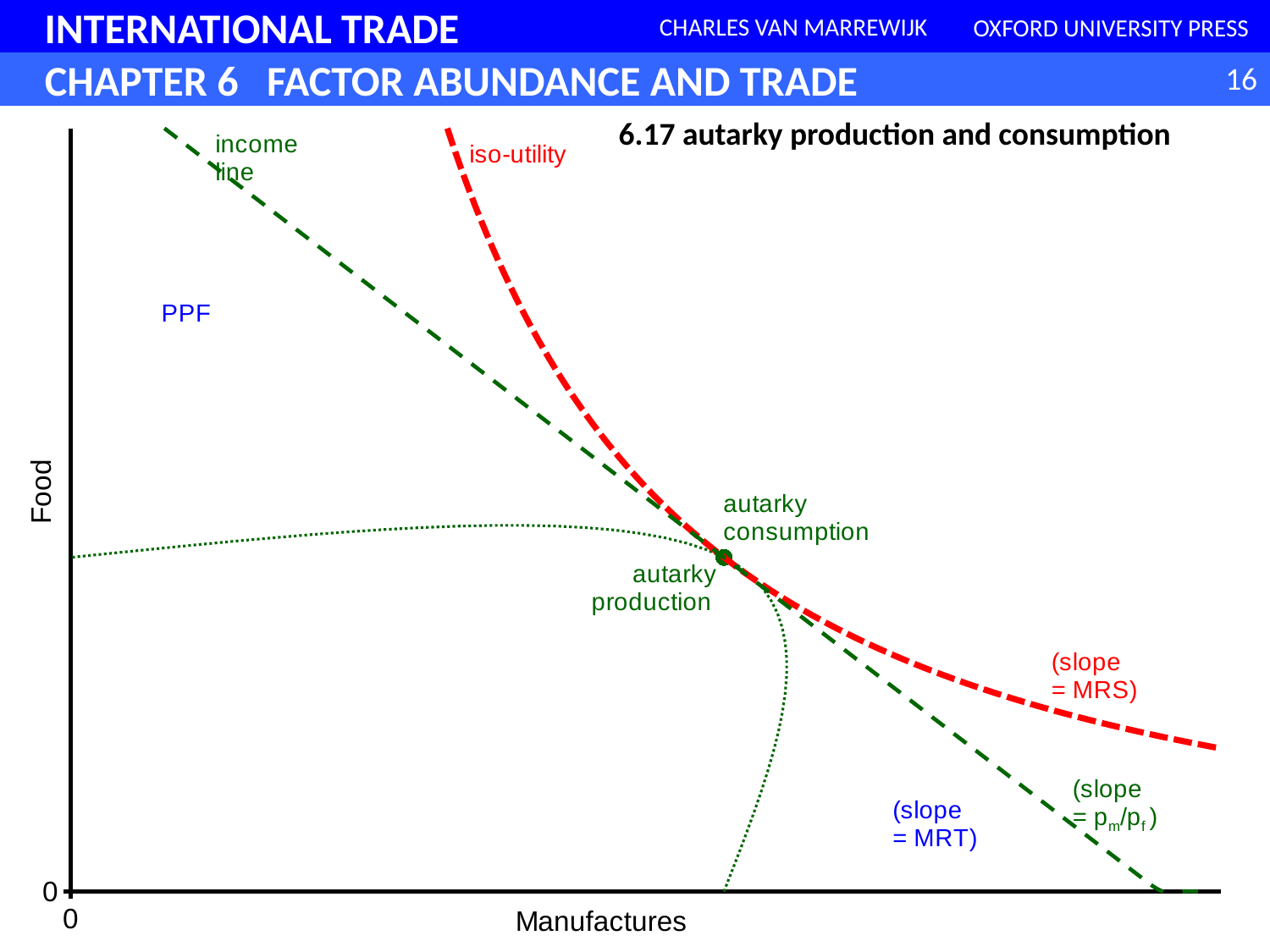
How many labeled curves (PPF, income line, iso-utility) are drawn on the chart? 3 Does the income line rise or fall as Manufactures increases along the x axis? fall What kind of chart is shown on the slide? line chart What is the title of the chart on the slide? 6.17 autarky production and consumption Does the iso-utility curve rise or fall as Manufactures increases along the x axis? fall What label is on the vertical axis of the chart? Food